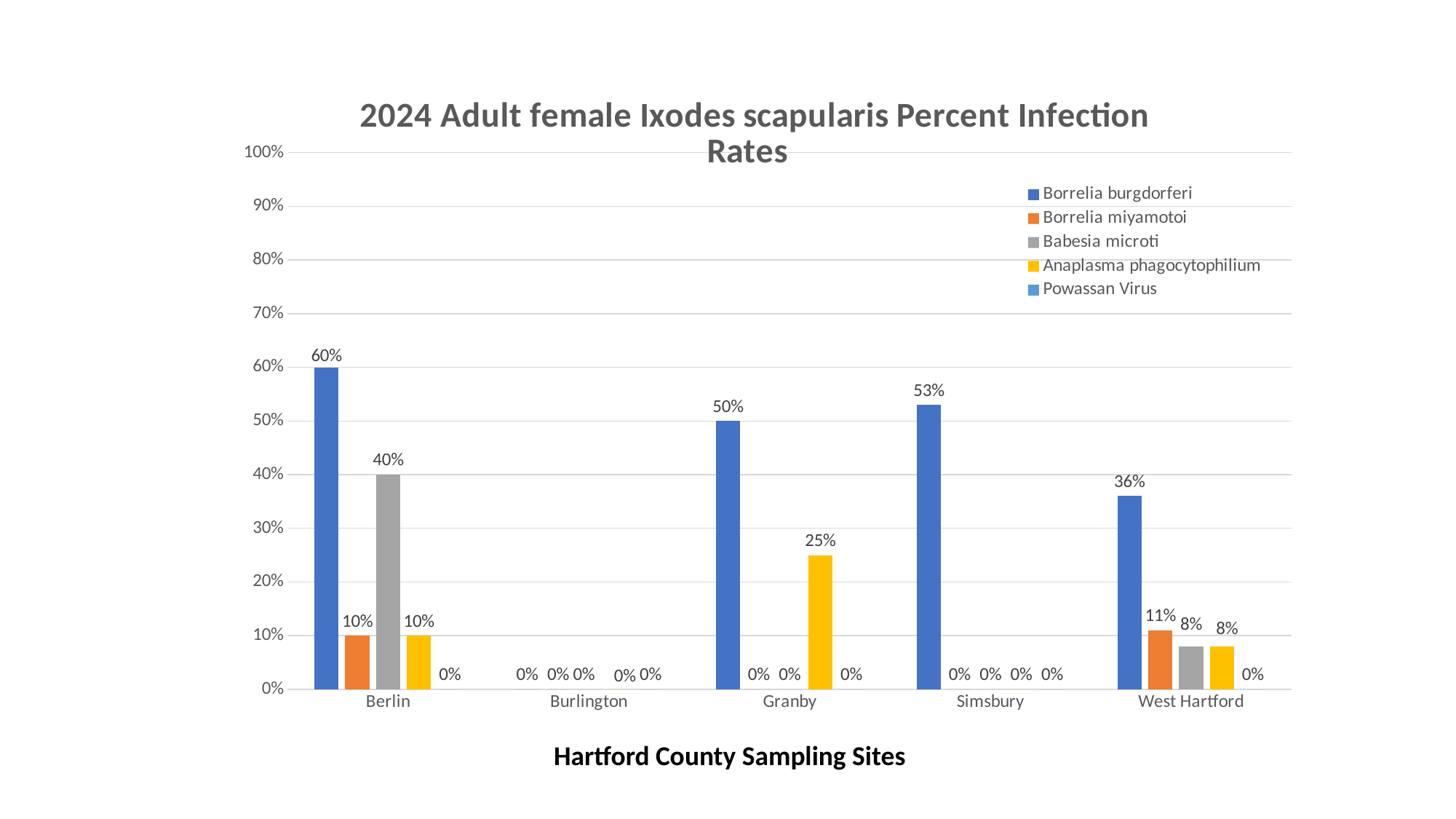
How many sampling sites are shown on the x axis? 5 What is the Anaplasma phagocytophilium infection rate for Granby? 25% What kind of chart is shown on the slide? Bar chart What is the Borrelia burgdorferi infection rate for Berlin? 60% What is the Babesia microti infection rate for Berlin? 40% Which sampling site has the highest Borrelia burgdorferi infection rate? Berlin What is the difference between the Borrelia burgdorferi infection rates for Berlin and West Hartford? 24% What is the Borrelia burgdorferi infection rate for Simsbury? 53% Which is larger, the Borrelia burgdorferi rate for Granby or for Simsbury? Simsbury How many series does the legend list? 5 What is the Borrelia miyamotoi infection rate for West Hartford? 11% Which sampling site has the lowest Borrelia burgdorferi infection rate? Burlington